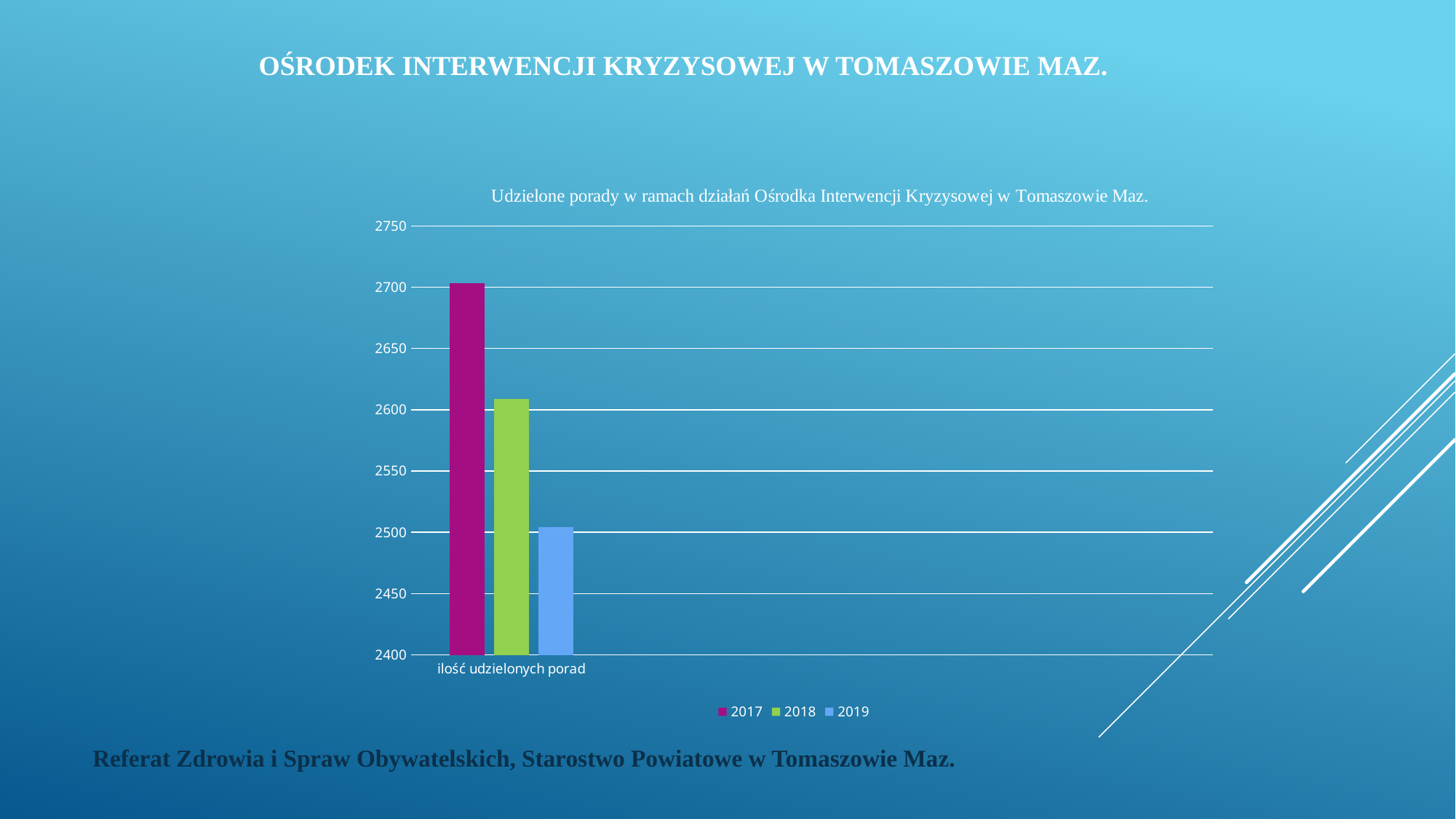
Which year has the lowest value for ilość udzielonych porad? 2019 Is the value for 2018 greater or less than 2650? less Is the value for 2017 greater or less than 2650? greater Which year has the highest value for ilość udzielonych porad? 2017 How many categories are shown on the x axis? 1 What is the title of the chart? Udzielone porady w ramach działań Ośrodka Interwencji Kryzysowej w Tomaszowie Maz. Is the value for 2019 greater or less than 2550? less Which is larger, the value for 2017 or the value for 2018? 2017 What kind of chart is shown on the slide? bar chart Do the values rise or fall from 2017 to 2019? fall Which is larger, the value for 2018 or the value for 2019? 2018 How many series does the legend list? 3